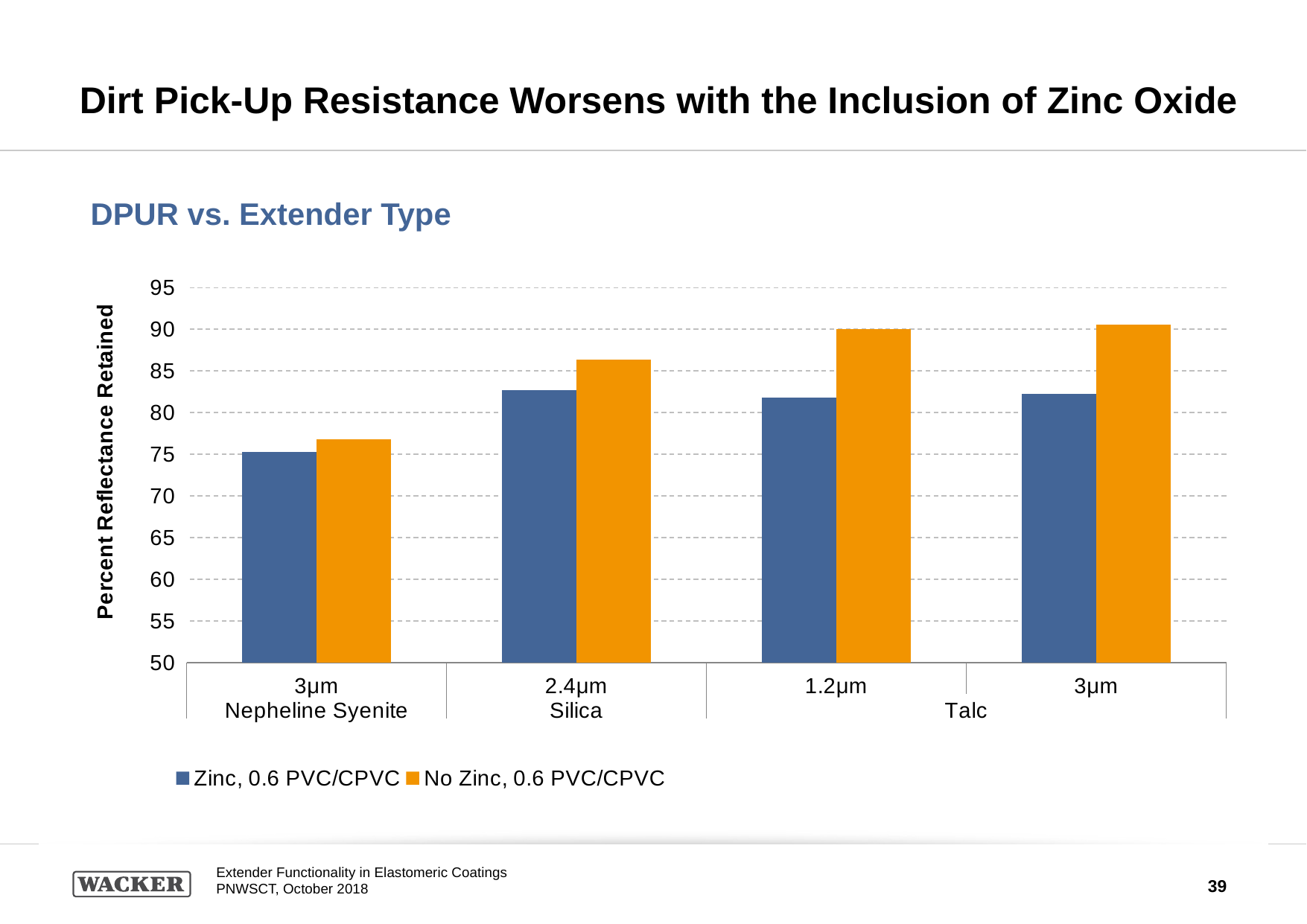
How many series does the legend list? 2 What is the label on the vertical axis of the chart? Percent Reflectance Retained Is the No Zinc, 0.6 PVC/CPVC value for 2.4µm Silica greater or less than 85? greater For 2.4µm Silica, which series has the larger value: Zinc, 0.6 PVC/CPVC or No Zinc, 0.6 PVC/CPVC? No Zinc, 0.6 PVC/CPVC Which extender has the lowest value for the Zinc, 0.6 PVC/CPVC series? 3µm Nepheline Syenite Is the No Zinc, 0.6 PVC/CPVC value for 1.2µm Talc greater or less than 85? greater Is the Zinc, 0.6 PVC/CPVC value for 1.2µm Talc greater or less than 85? less Which extender has the lowest value for the No Zinc, 0.6 PVC/CPVC series? 3µm Nepheline Syenite What kind of chart is shown on the slide? Bar chart How many extender categories are plotted along the x axis? 4 For 3µm Talc, which series has the larger value: Zinc, 0.6 PVC/CPVC or No Zinc, 0.6 PVC/CPVC? No Zinc, 0.6 PVC/CPVC